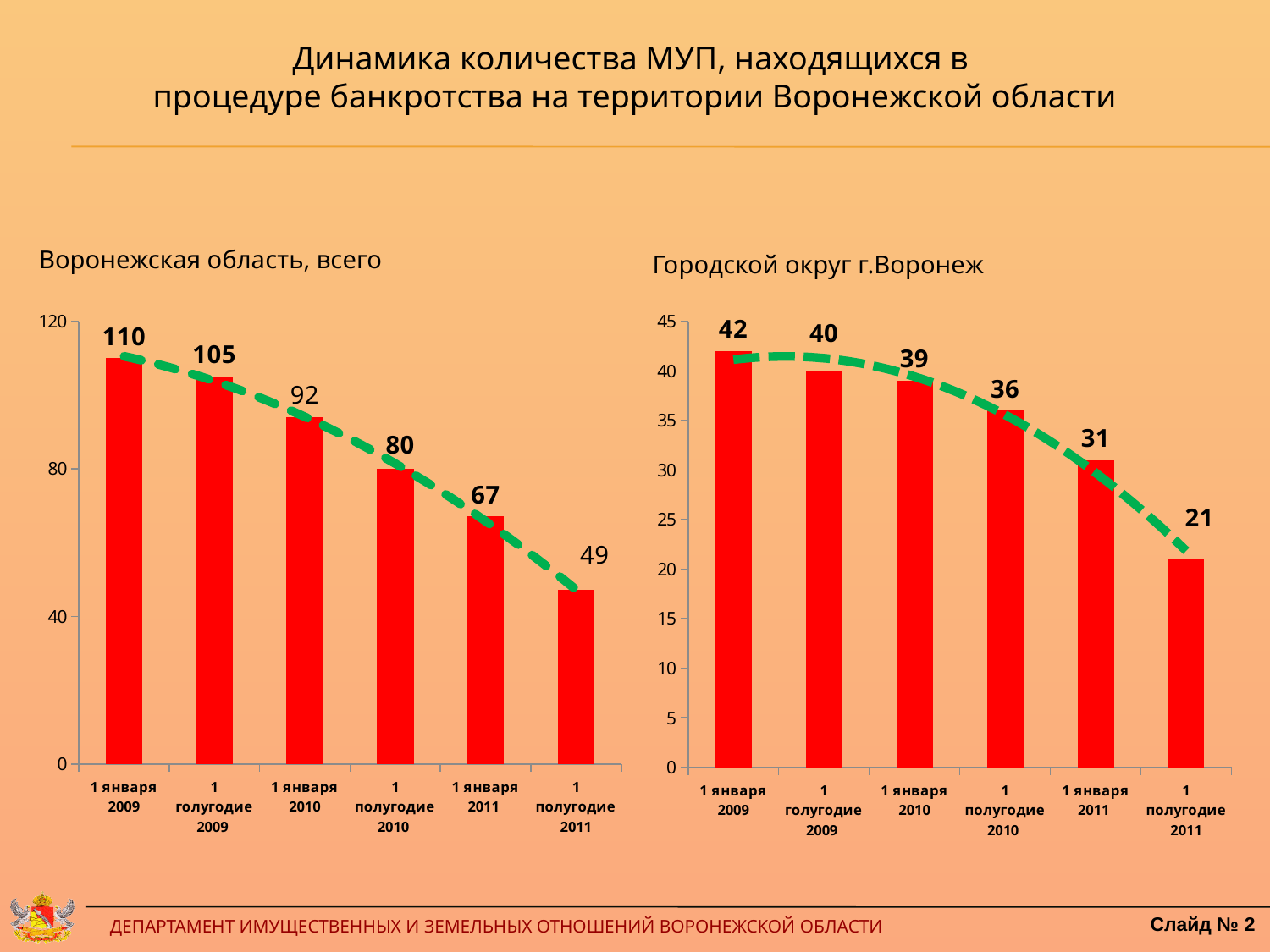
In the right chart 'Городской округ г.Воронеж', what is the difference between the values for 1 января 2009 and 1 полугодие 2011? 21 In the left chart 'Воронежская область, всего', what is the difference between the values for 1 января 2010 and 1 полугодие 2010? 12 In the right chart 'Городской округ г.Воронеж', which is larger: the value for 1 полугодие 2010 or 1 января 2011? 1 полугодие 2010 In the left chart 'Воронежская область, всего', is the value for 1 января 2011 greater or less than 80? less In the right chart 'Городской округ г.Воронеж', what is the value for 1 января 2010? 39 In the left chart 'Воронежская область, всего', which category has the highest value? 1 января 2009 In the left chart 'Воронежская область, всего', what is the value for 1 полугодие 2011? 49 How many categories are shown on the x axis of the right chart 'Городской округ г.Воронеж'? 6 What kind of chart is the left chart 'Воронежская область, всего'? bar chart In the left chart 'Воронежская область, всего', do the values rise or fall along the x axis? fall In the left chart 'Воронежская область, всего', what is the value for 1 января 2009? 110 In the right chart 'Городской округ г.Воронеж', which category has the lowest value? 1 полугодие 2011